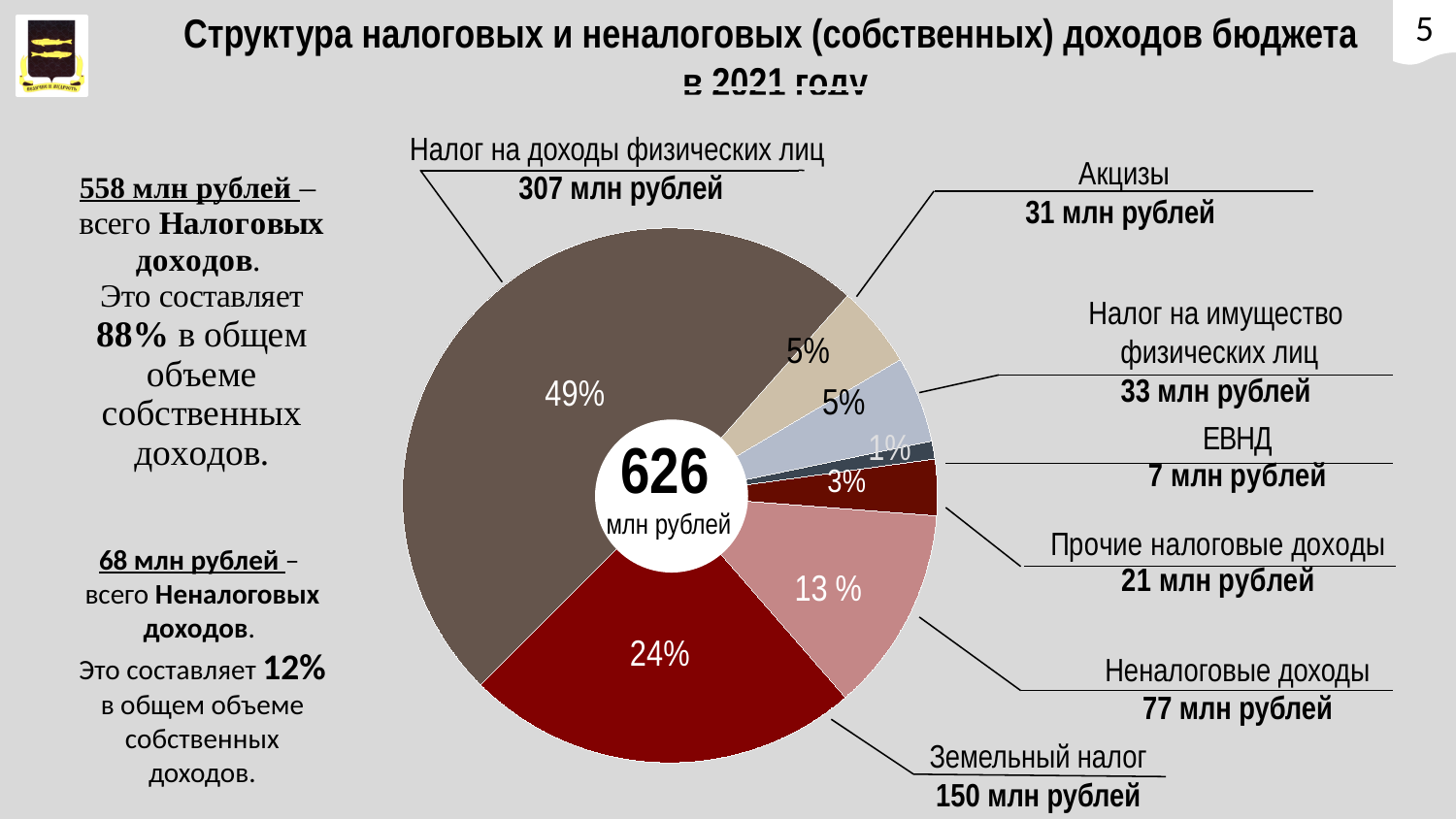
Which category has the largest value? Налог на доходы физических лиц How many categories does the pie chart show? 7 What is the value for Неналоговые доходы? 77 млн рублей Which is larger, Акцизы or Налог на имущество физических лиц? Налог на имущество физических лиц What share of the pie does Земельный налог represent? 24% What is the value for ЕВНД? 7 млн рублей Which category has the smallest value? ЕВНД What is the value for Земельный налог? 150 млн рублей What kind of chart is shown on the slide? pie chart What is the difference between Налог на доходы физических лиц and Земельный налог? 157 млн рублей What total value is shown in the centre of the pie chart? 626 млн рублей What is the value for Налог на доходы физических лиц? 307 млн рублей